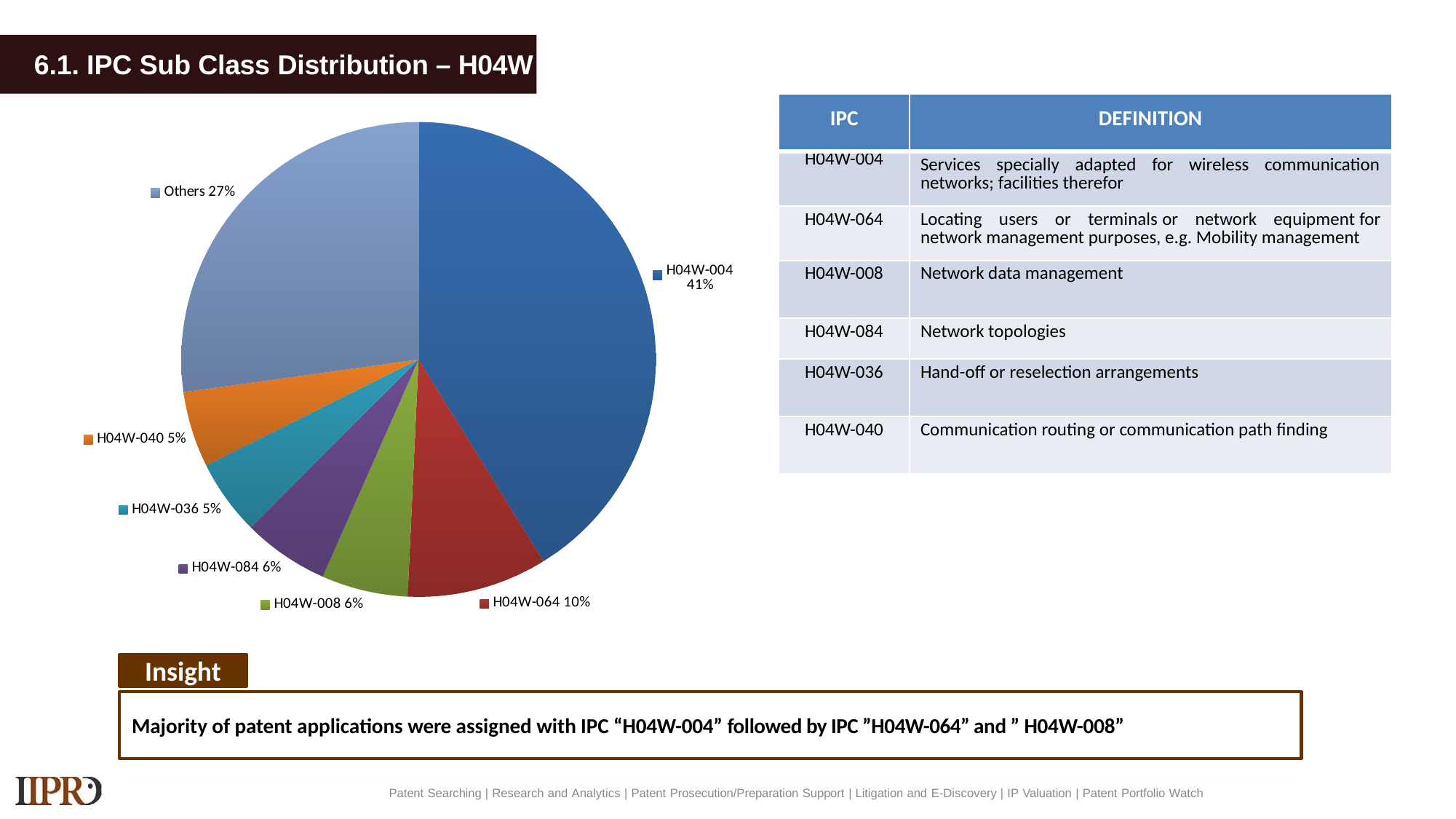
What kind of chart is shown on the slide? pie chart What is the difference in percentage points between H04W-004 and H04W-064? 31 What percentage is shown for Others? 27% What percentage is shown for H04W-084? 6% What share of the pie does H04W-004 represent? 41% What share of the pie does H04W-064 represent? 10% What percentage is shown for H04W-040? 5% How many slices does the pie chart have? 7 Which IPC sub class has the largest slice of the pie? H04W-004 What is the difference in percentage points between Others and H04W-040? 22 What colour is the slice for H04W-064? red Which is larger, the share for H04W-064 or the share for H04W-008? H04W-064